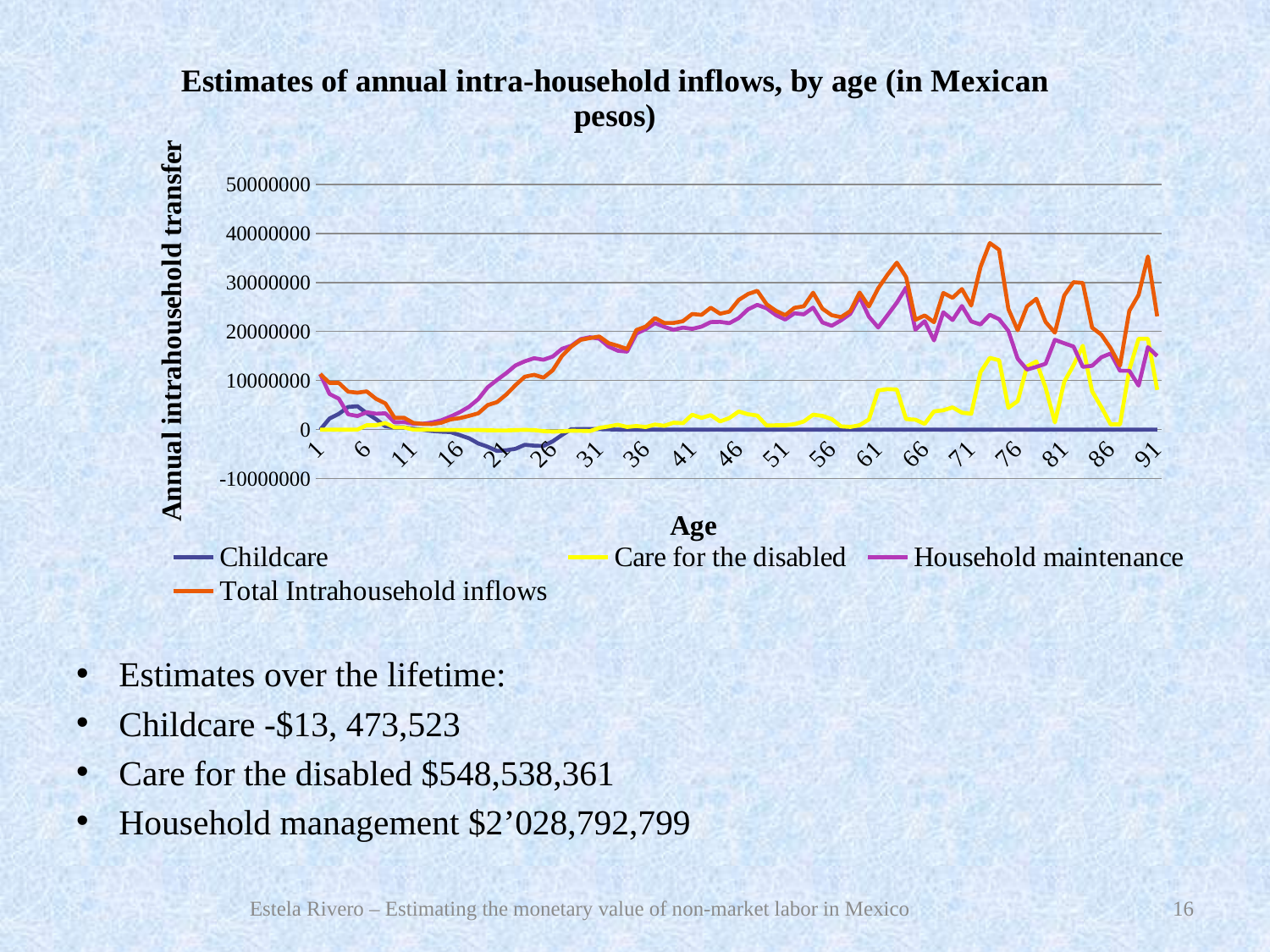
Is the value for Household maintenance at age 46 greater or less than 10000000? greater What is the label on the vertical axis of the chart? Annual intrahousehold transfer Is the value for Childcare at age 21 greater or less than 0? less What kind of chart is shown on the slide? Line chart Is the value for Total Intrahousehold inflows at age 71 greater or less than 20000000? greater How many series does the chart's legend list? 4 At age 61, which series has the larger value: Care for the disabled or Household maintenance? Household maintenance At age 36, which series has the larger value: Childcare or Total Intrahousehold inflows? Total Intrahousehold inflows What is the title of the chart? Estimates of annual intra-household inflows, by age (in Mexican pesos) Does the Total Intrahousehold inflows line generally rise or fall between age 11 and age 46? rise